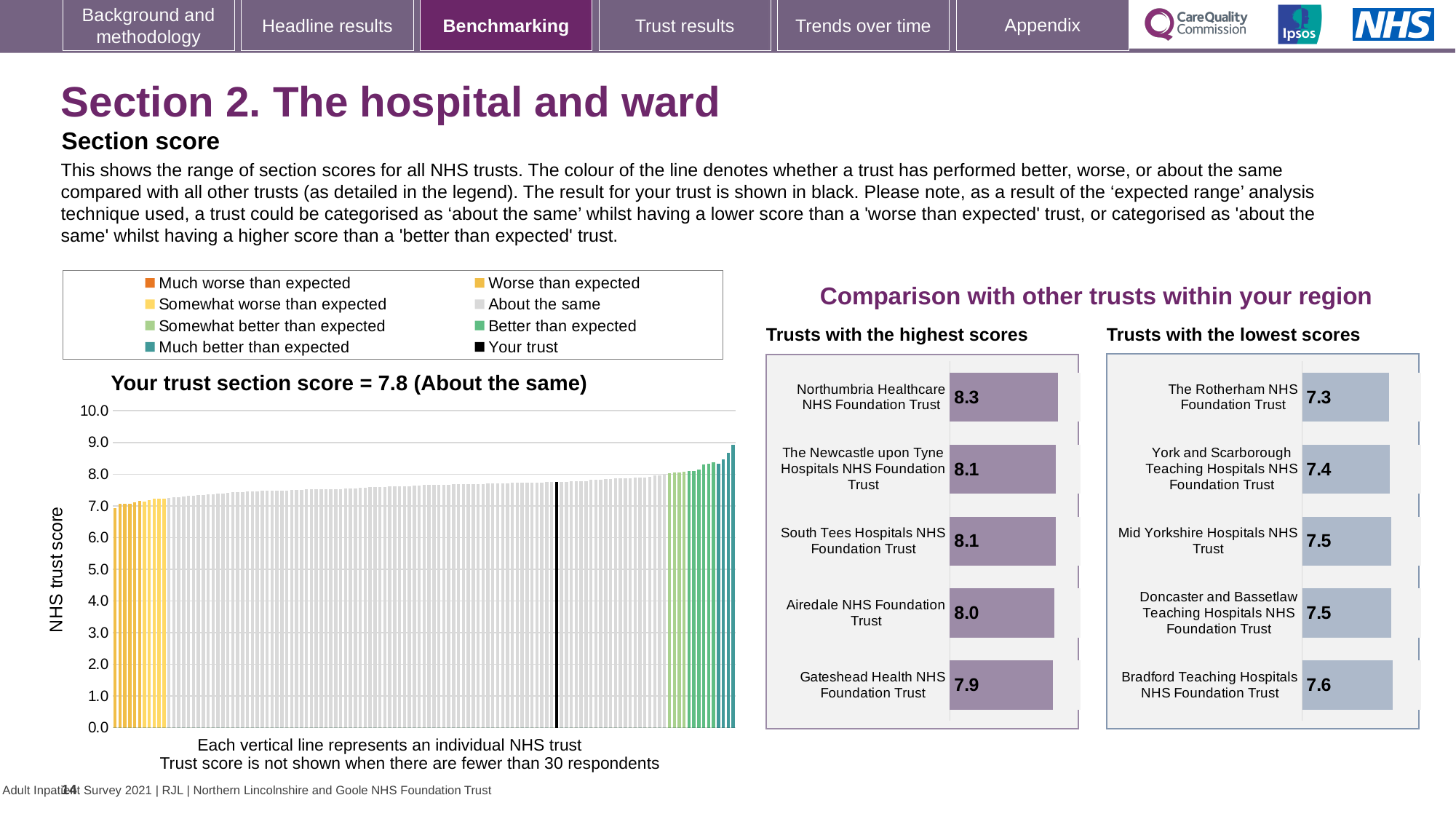
In the 'Trusts with the highest scores' chart, what is the score for Northumbria Healthcare NHS Foundation Trust? 8.3 In the 'Trusts with the lowest scores' chart, which trust has the lowest score? The Rotherham NHS Foundation Trust In the 'Trusts with the highest scores' chart, which trust has the highest score? Northumbria Healthcare NHS Foundation Trust In the main chart on the left, what is your trust's section score? 7.8 In the 'Trusts with the highest scores' chart, what is the score for Gateshead Health NHS Foundation Trust? 7.9 What kind of chart is the 'Trusts with the lowest scores' chart? Bar chart In the 'Trusts with the lowest scores' chart, which has the larger score: Mid Yorkshire Hospitals NHS Trust or The Rotherham NHS Foundation Trust? Mid Yorkshire Hospitals NHS Trust In the 'Trusts with the highest scores' chart, what is the difference between the scores of Northumbria Healthcare NHS Foundation Trust and Gateshead Health NHS Foundation Trust? 0.4 How many entries does the legend of the main chart on the left list? 8 In the main chart on the left, do the trust scores rise or fall from left to right? Rise How many trusts are shown in the 'Trusts with the highest scores' chart? 5 In the 'Trusts with the lowest scores' chart, what is the score for Bradford Teaching Hospitals NHS Foundation Trust? 7.6